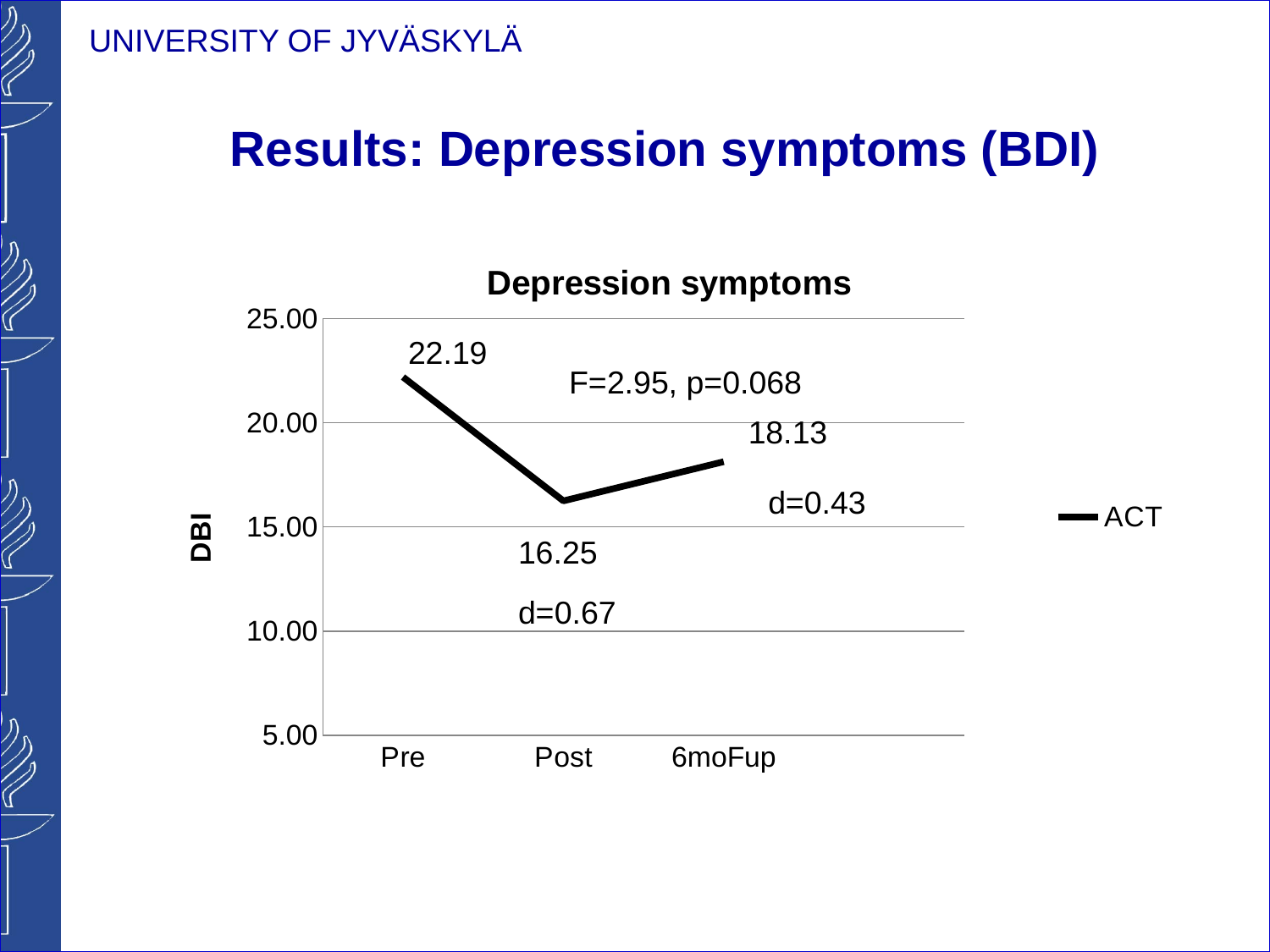
What is the BDI value at Post? 16.25 What kind of chart is shown? line chart How many series does the legend list? 1 Is the value at Pre greater or less than 20.00? greater At which time point is the BDI value lowest? Post How many time points are plotted on the chart? 3 Which is larger, the BDI value at Post or at 6moFup? 6moFup What is the difference between the BDI values at Pre and Post? 5.94 What is the BDI value at Pre? 22.19 What is the title of the chart? Depression symptoms What is the BDI value at 6moFup? 18.13 At which time point is the BDI value highest? Pre